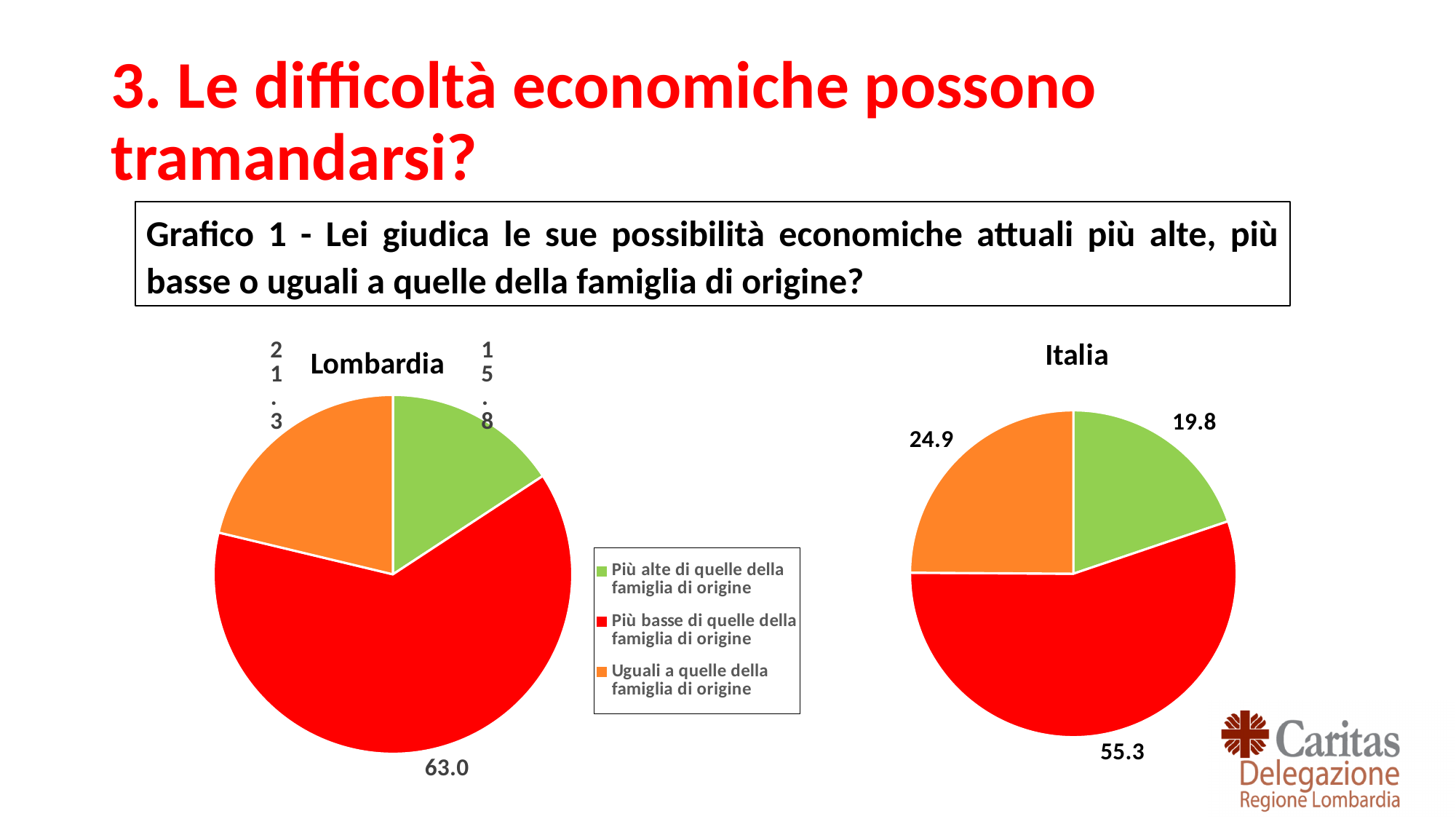
In the Lombardia chart, what is the value for 'Più alte di quelle della famiglia di origine'? 15.8 What is the difference between the 'Più basse' value in the Lombardia chart and the 'Più basse' value in the Italia chart? 7.7 In the Italia chart, which category has the largest slice? Più basse di quelle della famiglia di origine In the Lombardia chart, which category has the smallest slice? Più alte di quelle della famiglia di origine How many entries does the legend list? 3 Which is larger: the 'Uguali' value in the Lombardia chart or the 'Uguali' value in the Italia chart? Italia In the Italia chart, what is the value for 'Più alte di quelle della famiglia di origine'? 19.8 In the Italia chart, what is the value for 'Uguali a quelle della famiglia di origine'? 24.9 In the Lombardia chart, what is the value for 'Più basse di quelle della famiglia di origine'? 63.0 How many slices does the Italia pie chart have? 3 What type of chart is used for the Lombardia data? pie chart What colour represents 'Uguali a quelle della famiglia di origine' in the charts? orange